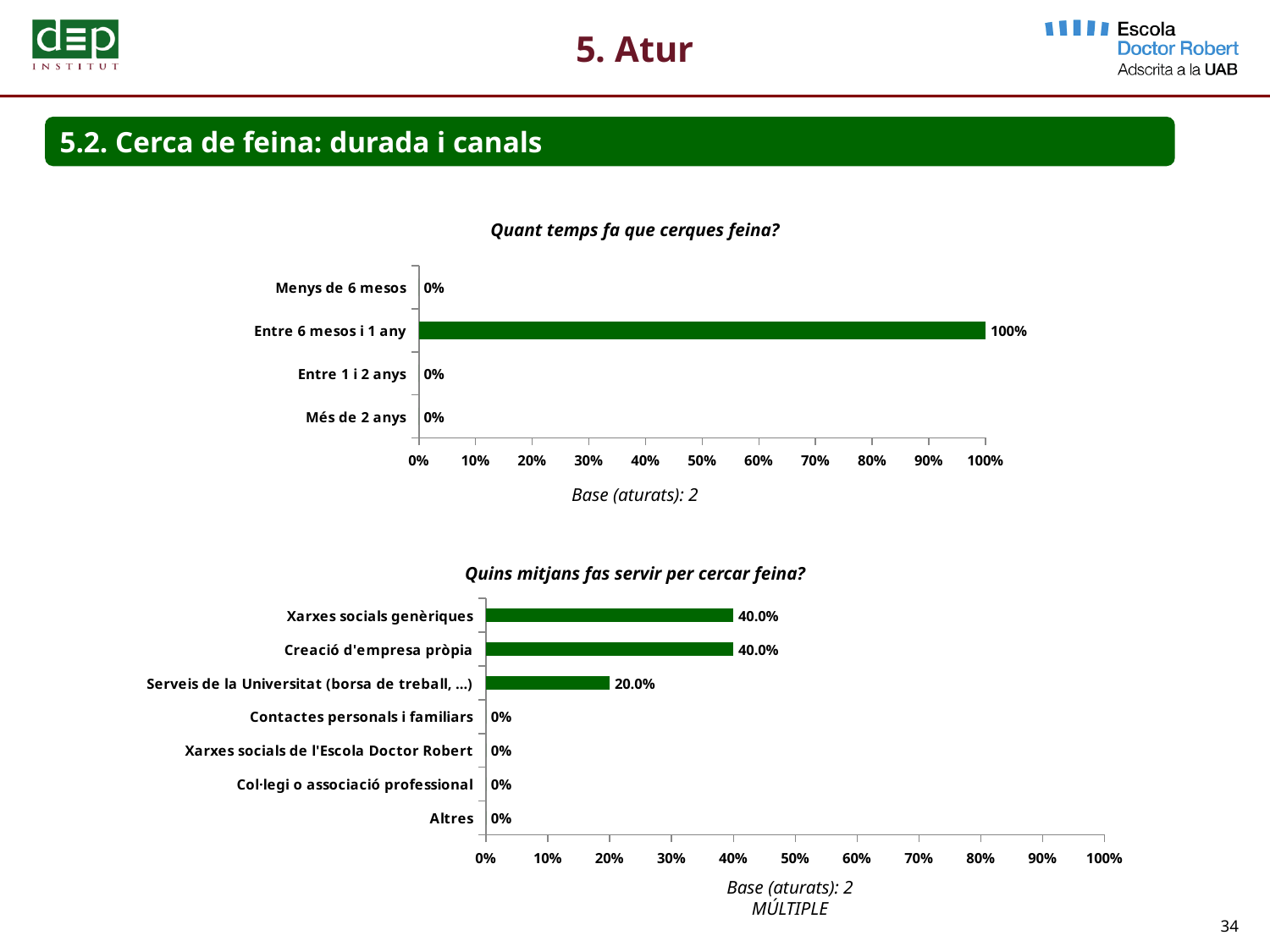
In the chart 'Quins mitjans fas servir per cercar feina?', which is larger: 'Creació d'empresa pròpia' or 'Serveis de la Universitat (borsa de treball, ...)'? Creació d'empresa pròpia In the chart 'Quins mitjans fas servir per cercar feina?', what is the difference between 'Xarxes socials genèriques' and 'Serveis de la Universitat (borsa de treball, ...)'? 20.0% What base (number of respondents) is stated below the chart 'Quins mitjans fas servir per cercar feina?'? Base (aturats): 2 In the chart 'Quins mitjans fas servir per cercar feina?', what is the value for 'Contactes personals i familiars'? 0% How many categories are shown in the chart 'Quins mitjans fas servir per cercar feina?'? 7 In the chart 'Quant temps fa que cerques feina?', which category has the highest value? Entre 6 mesos i 1 any What kind of chart is 'Quant temps fa que cerques feina?'? Bar chart In the chart 'Quant temps fa que cerques feina?', what is the value for 'Entre 6 mesos i 1 any'? 100% In the chart 'Quins mitjans fas servir per cercar feina?', what is the value for 'Creació d'empresa pròpia'? 40.0% How many categories are shown in the chart 'Quant temps fa que cerques feina?'? 4 In the chart 'Quant temps fa que cerques feina?', what is the value for 'Més de 2 anys'? 0% In the chart 'Quins mitjans fas servir per cercar feina?', what is the value for 'Serveis de la Universitat (borsa de treball, ...)'? 20.0%